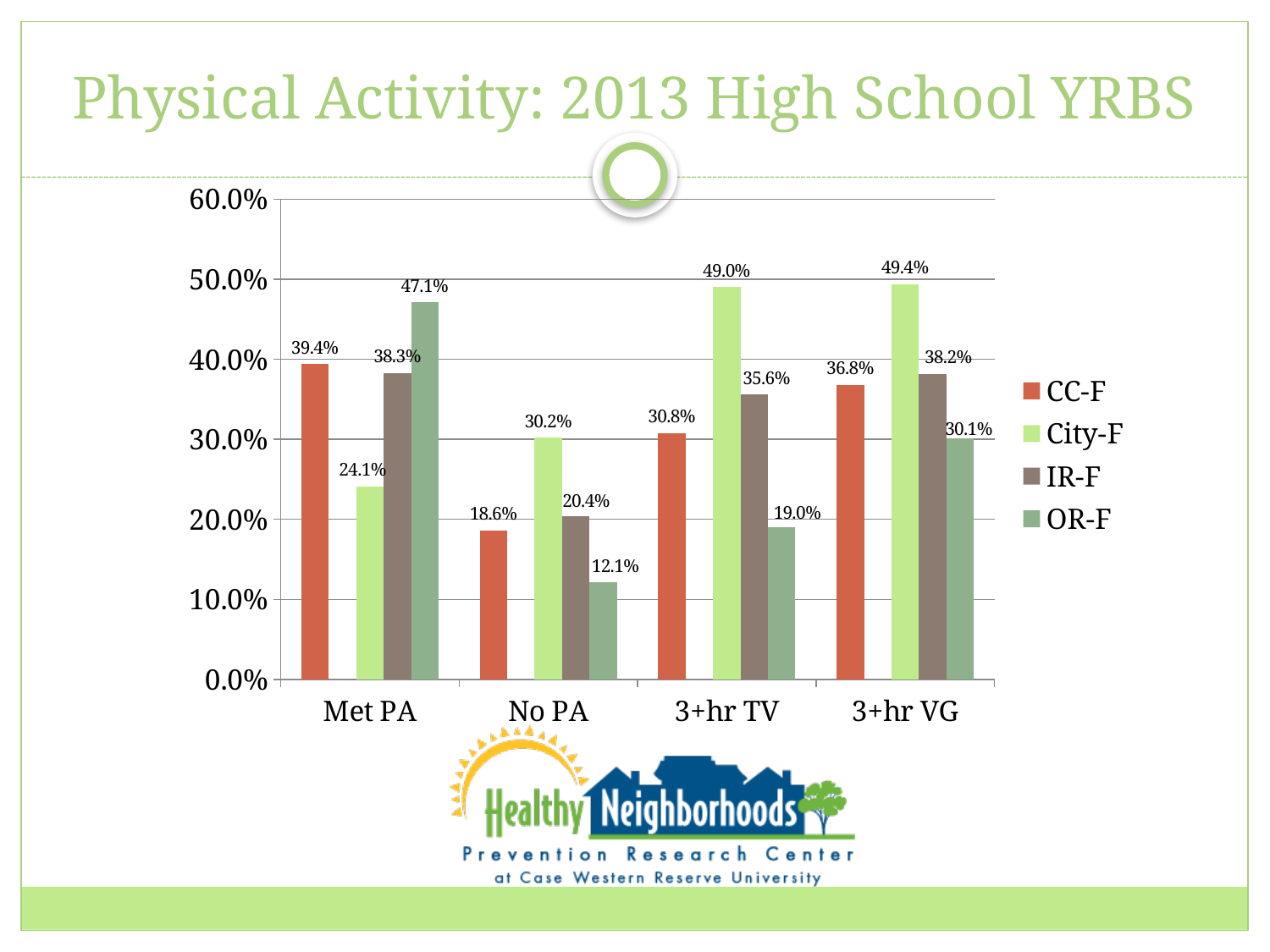
Which series has the highest value in the Met PA category? OR-F How many series does the legend list? 4 How many categories are shown on the x axis? 4 Which is larger: the IR-F value for Met PA or the IR-F value for 3+hr VG? Met PA What is the value for City-F in the 3+hr VG category? 49.4% What is the title of the slide containing the chart? Physical Activity: 2013 High School YRBS What is the difference between the City-F and CC-F values in the 3+hr TV category? 18.2% What is the value for CC-F in the Met PA category? 39.4% What is the value for IR-F in the 3+hr TV category? 35.6% Which series has the lowest value in the 3+hr TV category? OR-F What is the value for OR-F in the No PA category? 12.1% What kind of chart is shown on the slide? Bar chart